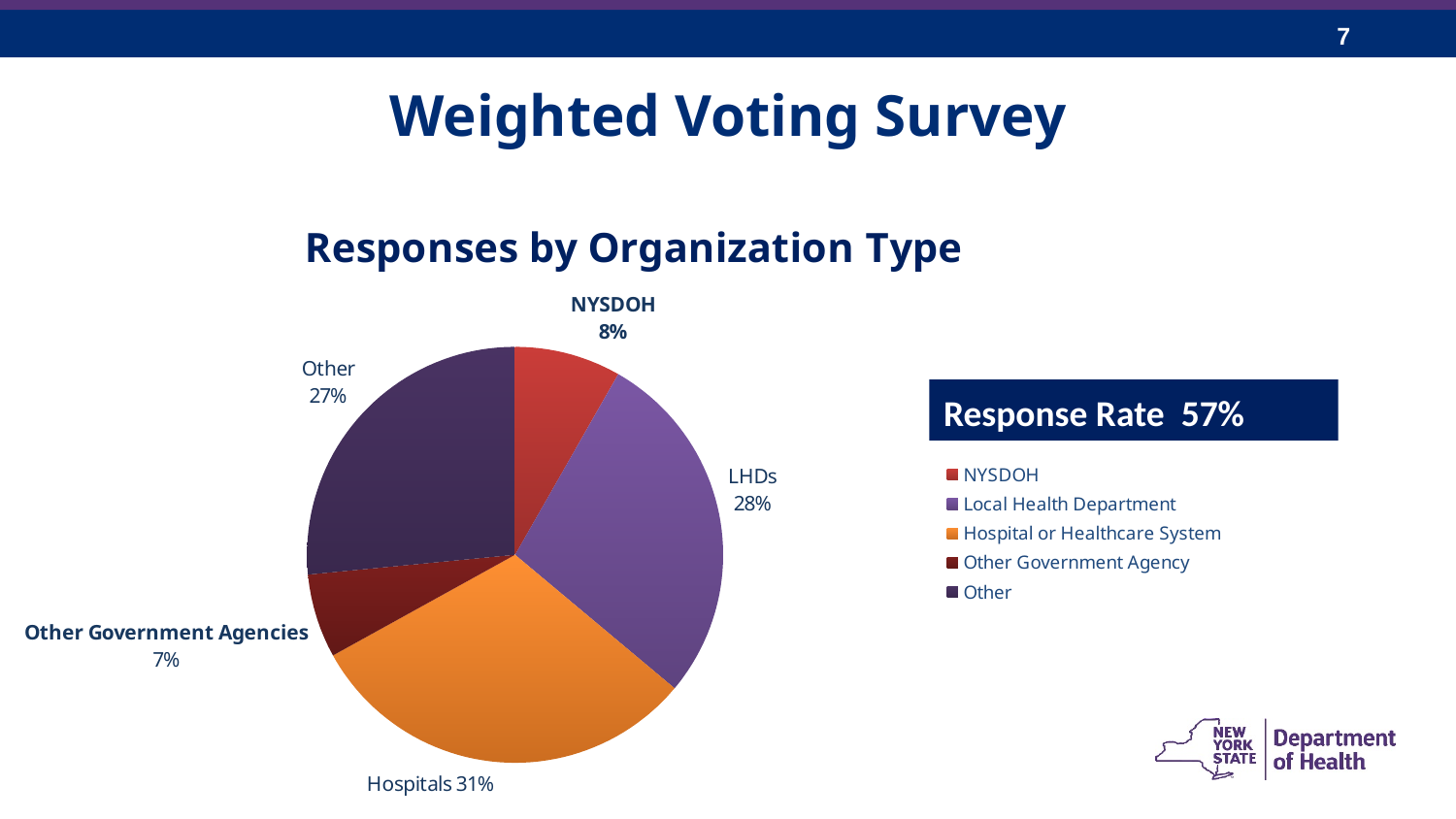
Which is larger, the LHDs slice or the Other slice? LHDs Which organization type has the smallest share of responses? Other Government Agencies How many slices does the pie chart have? 5 What is the difference in percentage points between the Hospitals slice and the Other slice? 4 What kind of chart is shown on the slide? pie chart How many entries does the legend list? 5 What percentage of responses came from Other Government Agencies? 7% What is the chart's title? Responses by Organization Type What percentage of responses came from NYSDOH? 8% Which organization type has the largest share of responses? Hospitals What percentage of responses came from LHDs? 28% What percentage of responses came from Hospitals? 31%